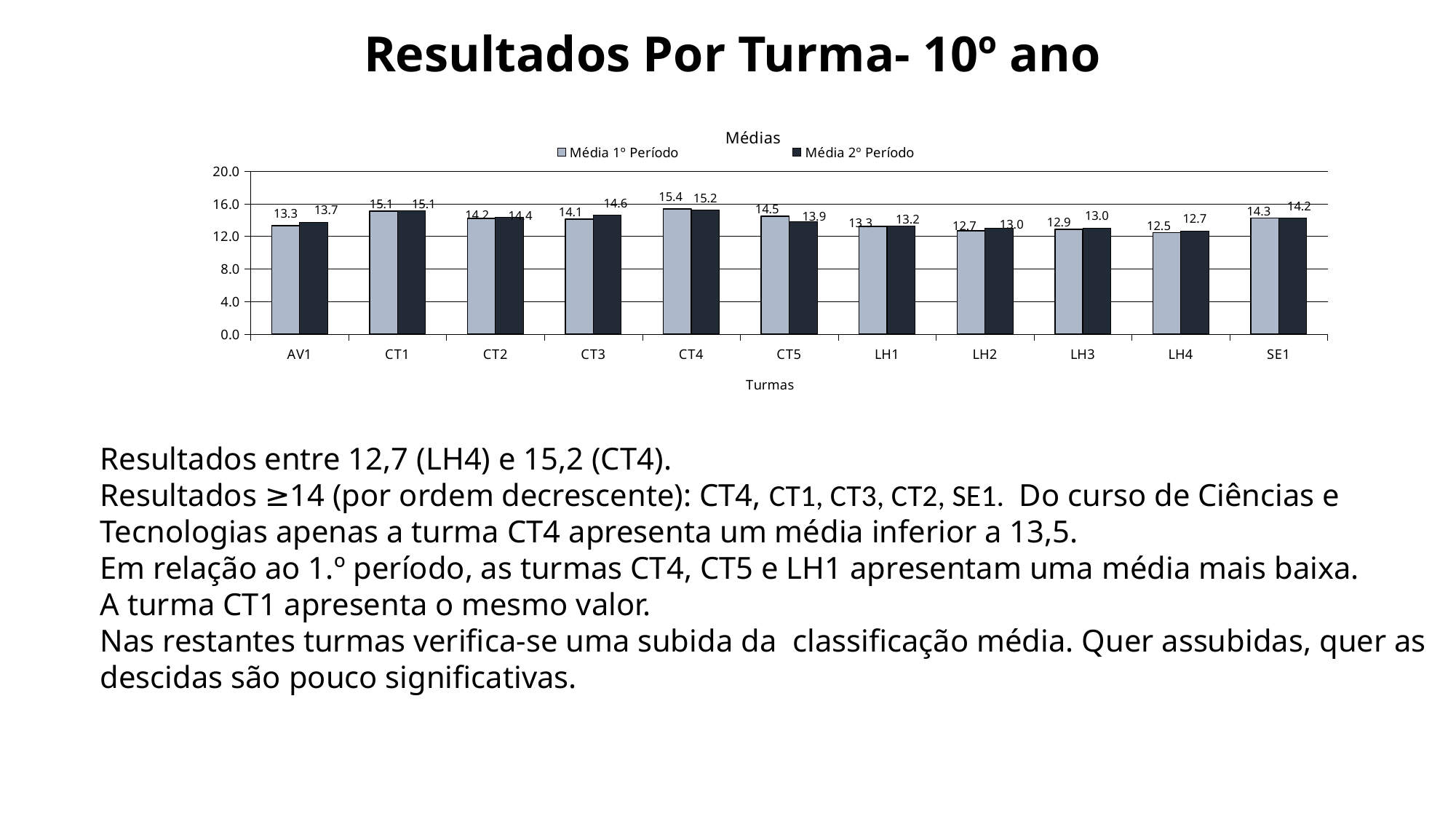
What is the title of the chart? Médias What is the Média 2º Período value for LH4? 12.7 Which turma has the highest Média 1º Período? CT4 What kind of chart is shown? bar chart Is the Média 1º Período value for LH2 greater or less than 16.0? less What is the Média 2º Período value for CT3? 14.6 What is the Média 1º Período value for CT4? 15.4 Which is larger for AV1: Média 1º Período or Média 2º Período? Média 2º Período How many series does the legend list? 2 How many turmas are shown on the x axis? 11 Which turma has the lowest Média 2º Período? LH4 What is the difference between the Média 1º Período and Média 2º Período values for CT5? 0.6